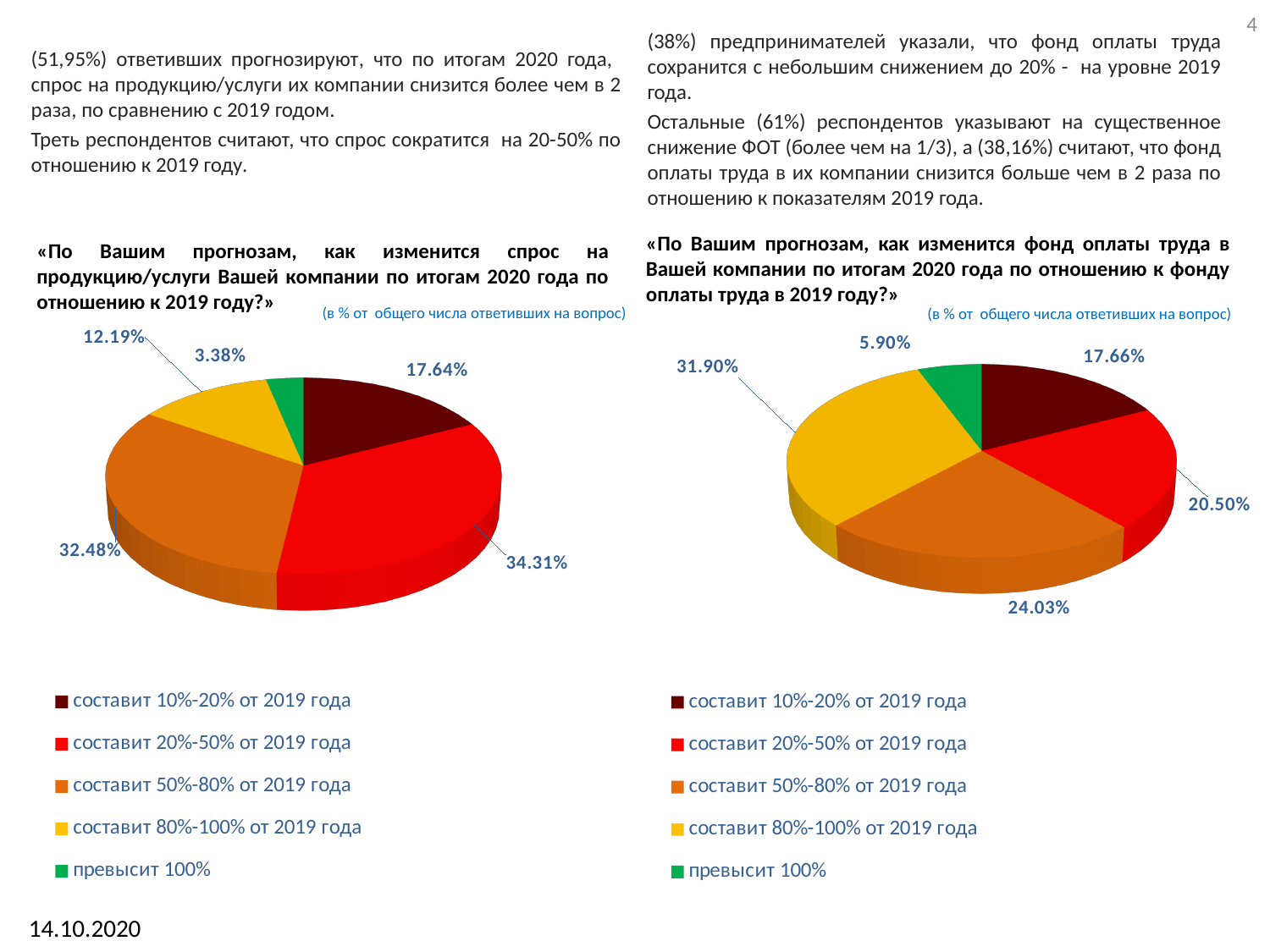
On the left pie chart (demand forecast), what share of respondents answered "превысит 100%"? 3.38% On the left pie chart (demand forecast), which category has the largest share? составит 20%-50% от 2019 года On the left pie chart (demand forecast), which category has the smallest share? превысит 100% On the right pie chart (payroll forecast), what share of respondents answered "составит 50%-80% от 2019 года"? 24.03% On the right pie chart (payroll forecast), which category has the largest share? составит 80%-100% от 2019 года How many categories does the legend of the right pie chart list? 5 On the right pie chart (payroll forecast), which is larger: the share for "составит 20%-50% от 2019 года" or for "составит 50%-80% от 2019 года"? составит 50%-80% от 2019 года On the right pie chart (payroll forecast), what share of respondents answered "составит 80%-100% от 2019 года"? 31.90% On the right pie chart (payroll forecast), which category has the smallest share? превысит 100% On the left pie chart (demand forecast), what is the difference between the shares for "составит 50%-80% от 2019 года" and "составит 80%-100% от 2019 года"? 20.29% On the left pie chart (demand forecast), what share of respondents answered "составит 20%-50% от 2019 года"? 34.31% What type of chart is used on the left side of the slide? Pie chart